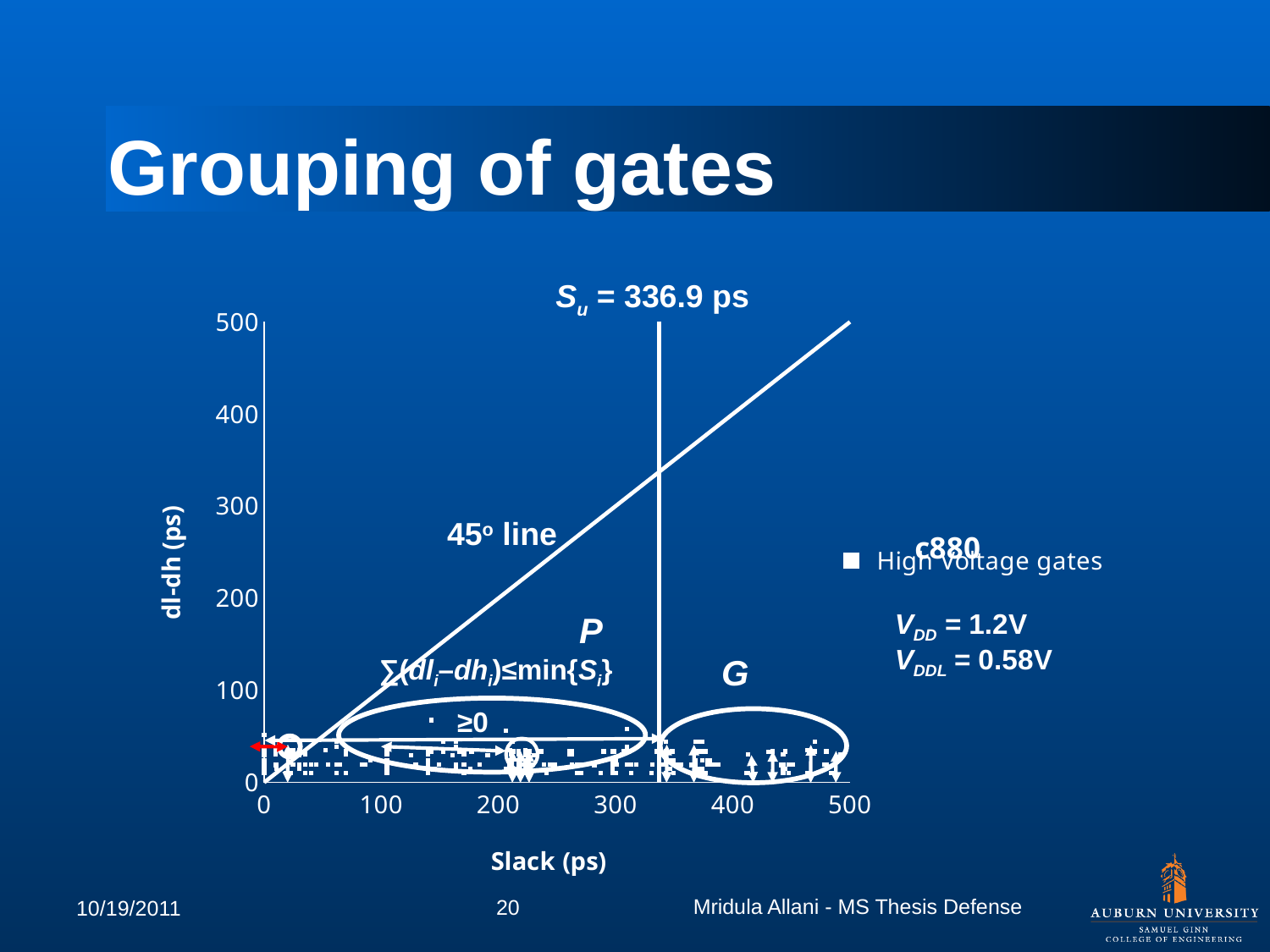
What is the title of the chart? c880 What kind of chart is shown on the slide? scatter chart Are the dl-dh values of the plotted gates greater or less than 100 ps? less What value of S_u is marked by the vertical line on the chart? 336.9 ps Are the dl-dh values of the plotted gates greater or less than 200 ps? less How many series does the chart's legend list? 1